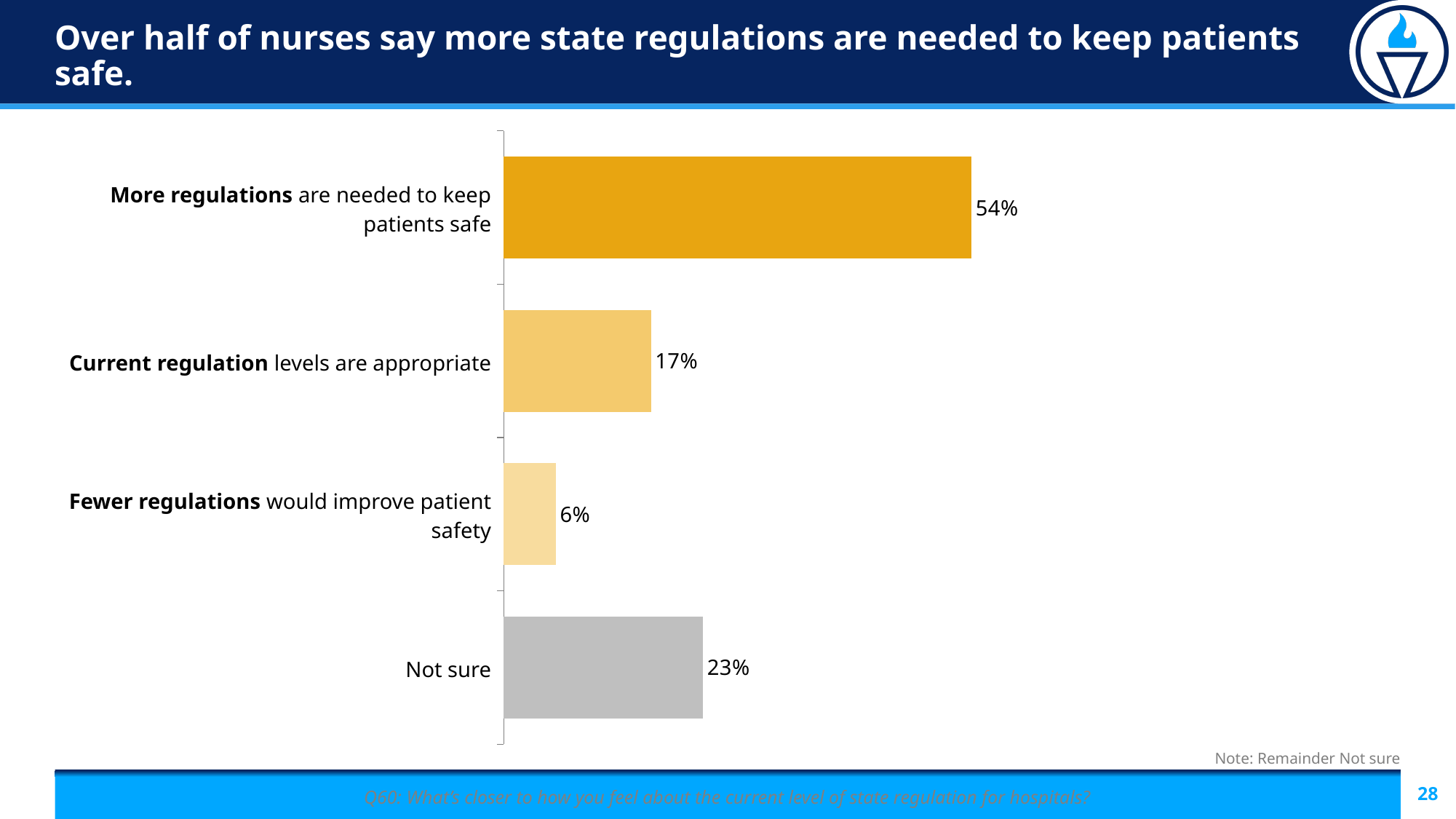
What is the difference in percentage points between 'Not sure' and 'Fewer regulations would improve patient safety'? 17 percentage points How many response categories are shown in the chart? 4 What percentage of nurses say current regulation levels are appropriate? 17% What percentage of nurses say fewer regulations would improve patient safety? 6% What type of chart is shown on the slide? Bar chart What is the difference in percentage points between 'More regulations are needed to keep patients safe' and 'Current regulation levels are appropriate'? 37 percentage points What percentage of nurses say more regulations are needed to keep patients safe? 54% What percentage of nurses answered 'Not sure'? 23% What colour is the bar for 'Not sure'? Gray Which response has the highest percentage? More regulations are needed to keep patients safe Which response has the lowest percentage? Fewer regulations would improve patient safety Which is larger: the percentage for 'Not sure' or for 'Current regulation levels are appropriate'? Not sure